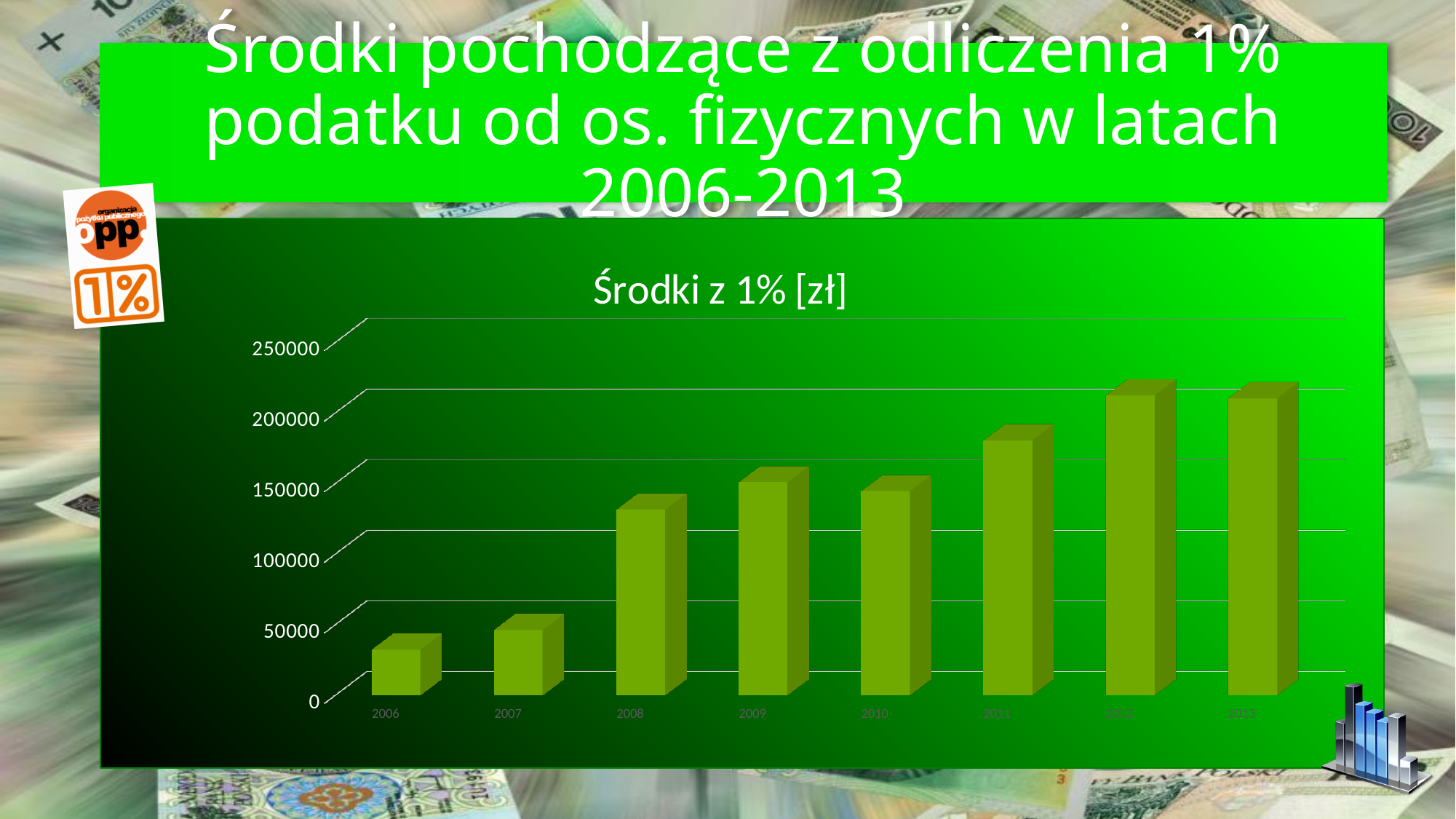
Do the values generally rise or fall from 2006 to 2013? rise Is the value for 2006 greater or less than 50000? less Is the value for 2011 greater or less than 150000? greater What kind of chart is shown on the slide? bar chart Which is larger, the value for 2007 or the value for 2008? 2008 What is the title of the chart? Środki z 1% [zł] Is the value for 2007 greater or less than 100000? less Which year has the lowest value in the chart? 2006 How many years are shown on the x axis of the chart? 8 Which is larger, the value for 2010 or the value for 2011? 2011